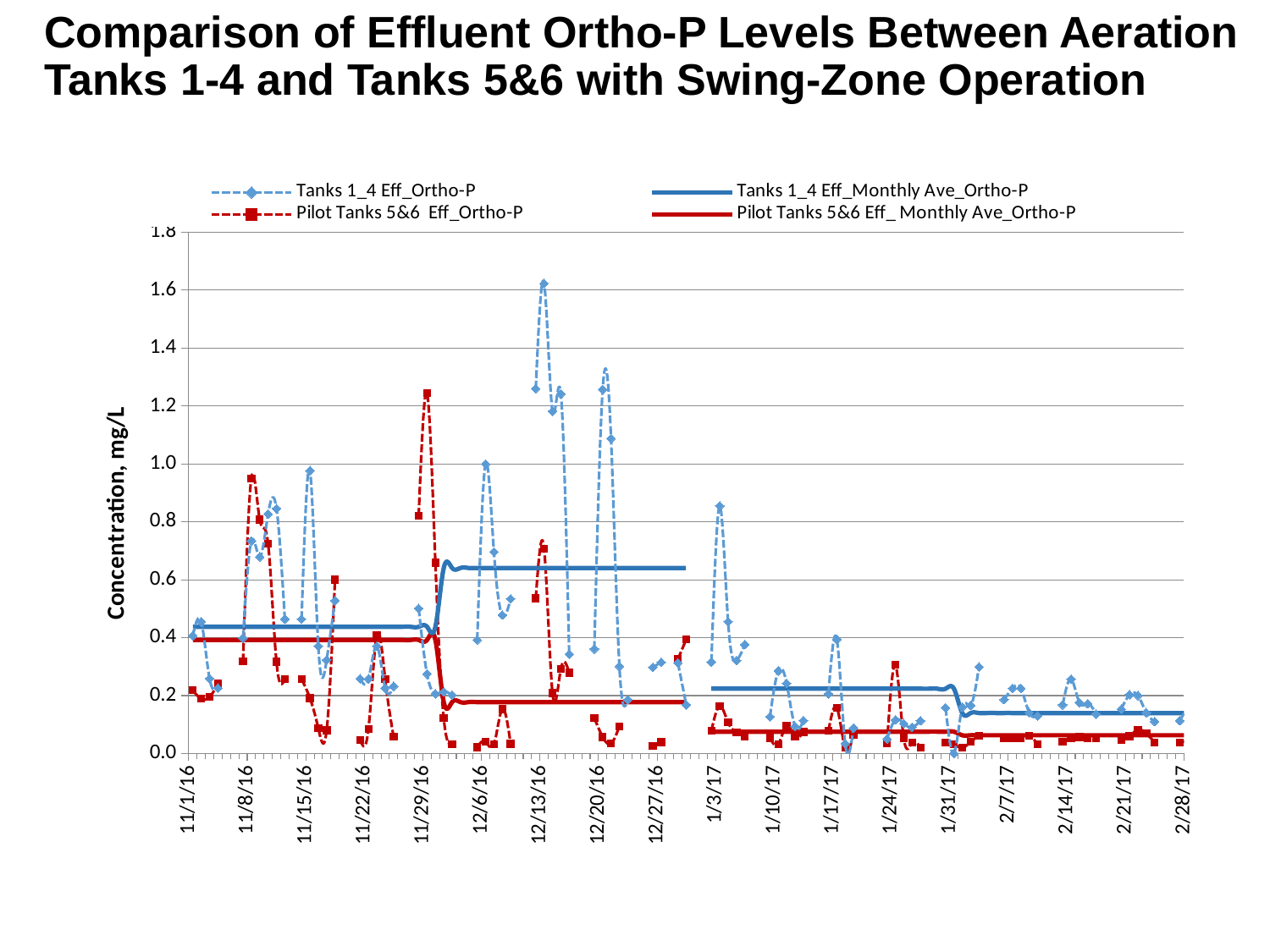
Which series reaches the highest single value on the chart? Tanks 1_4 Eff_Ortho-P What is the highest value shown on the vertical axis? 1.8 What is the label on the vertical axis? Concentration, mg/L Does the Tanks 1_4 Eff_Monthly Ave_Ortho-P line rise or fall from December 2016 to February 2017? fall Is the Tanks 1_4 Eff_Monthly Ave_Ortho-P value during December 2016 greater or less than 0.6? greater During December 2016, which monthly average line is higher: Tanks 1_4 Eff_Monthly Ave_Ortho-P or Pilot Tanks 5&6 Eff_ Monthly Ave_Ortho-P? Tanks 1_4 Eff_Monthly Ave_Ortho-P Is the peak value of the Tanks 1_4 Eff_Ortho-P series near 12/13/16 greater or less than 1.4? greater Is the Pilot Tanks 5&6 Eff_ Monthly Ave_Ortho-P value during January 2017 greater or less than 0.2? less How many series does the legend list? 4 What kind of chart is shown on the slide? line chart